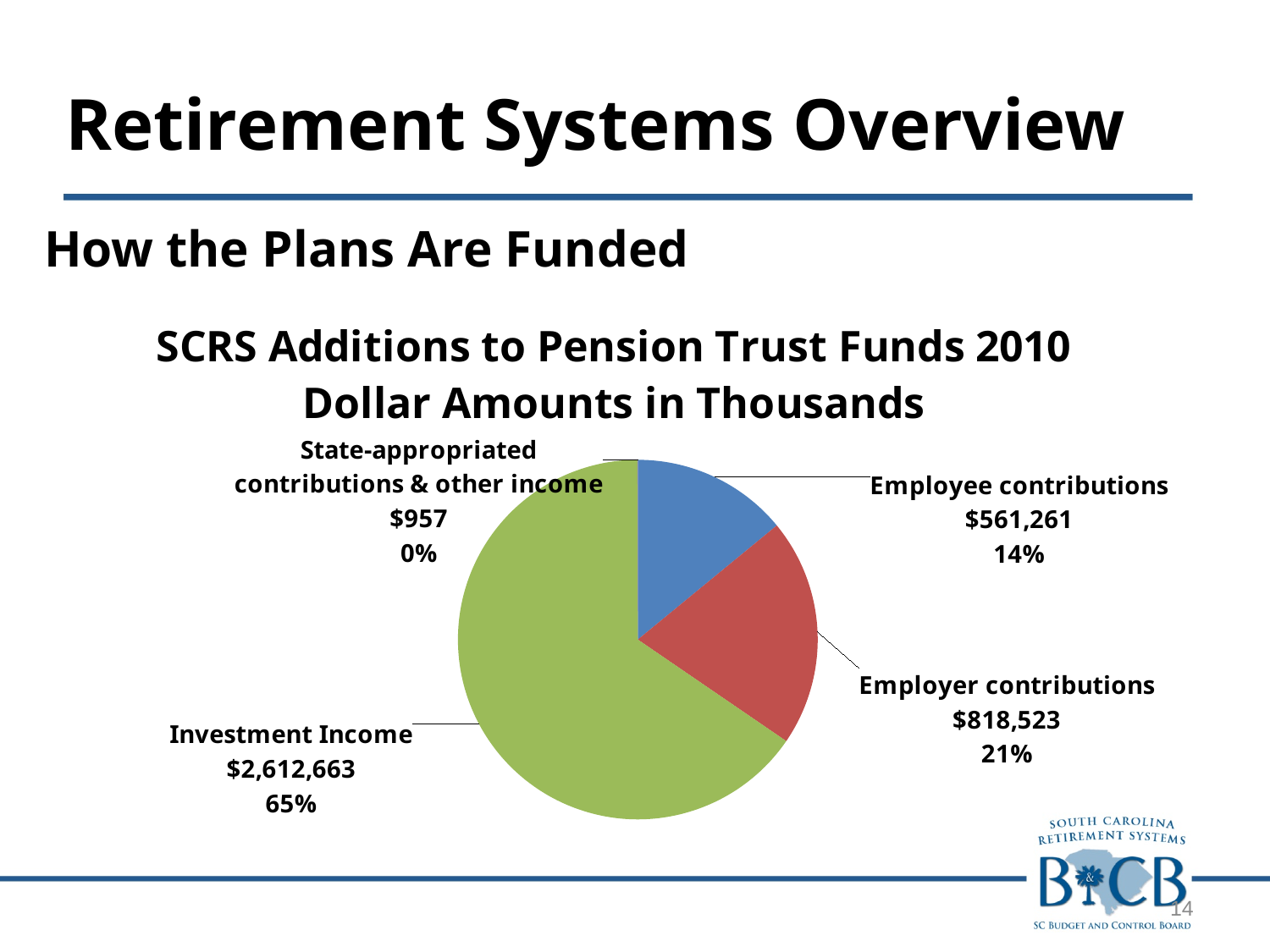
What is the difference in dollar amount between Employer contributions and Employee contributions? $257,262 What is the dollar amount for Employee contributions? $561,261 What share of the pie does Investment Income represent? 65% Which is larger, Employer contributions or Employee contributions? Employer contributions What is the dollar amount for State-appropriated contributions & other income? $957 What is the dollar amount for Investment Income? $2,612,663 How many categories are shown in the pie chart? 4 What share of the pie does Employer contributions represent? 21% What type of chart is shown on the slide? pie chart Which category has the largest slice of the pie? Investment Income Which category has the smallest slice of the pie? State-appropriated contributions & other income What is the dollar amount for Employer contributions? $818,523